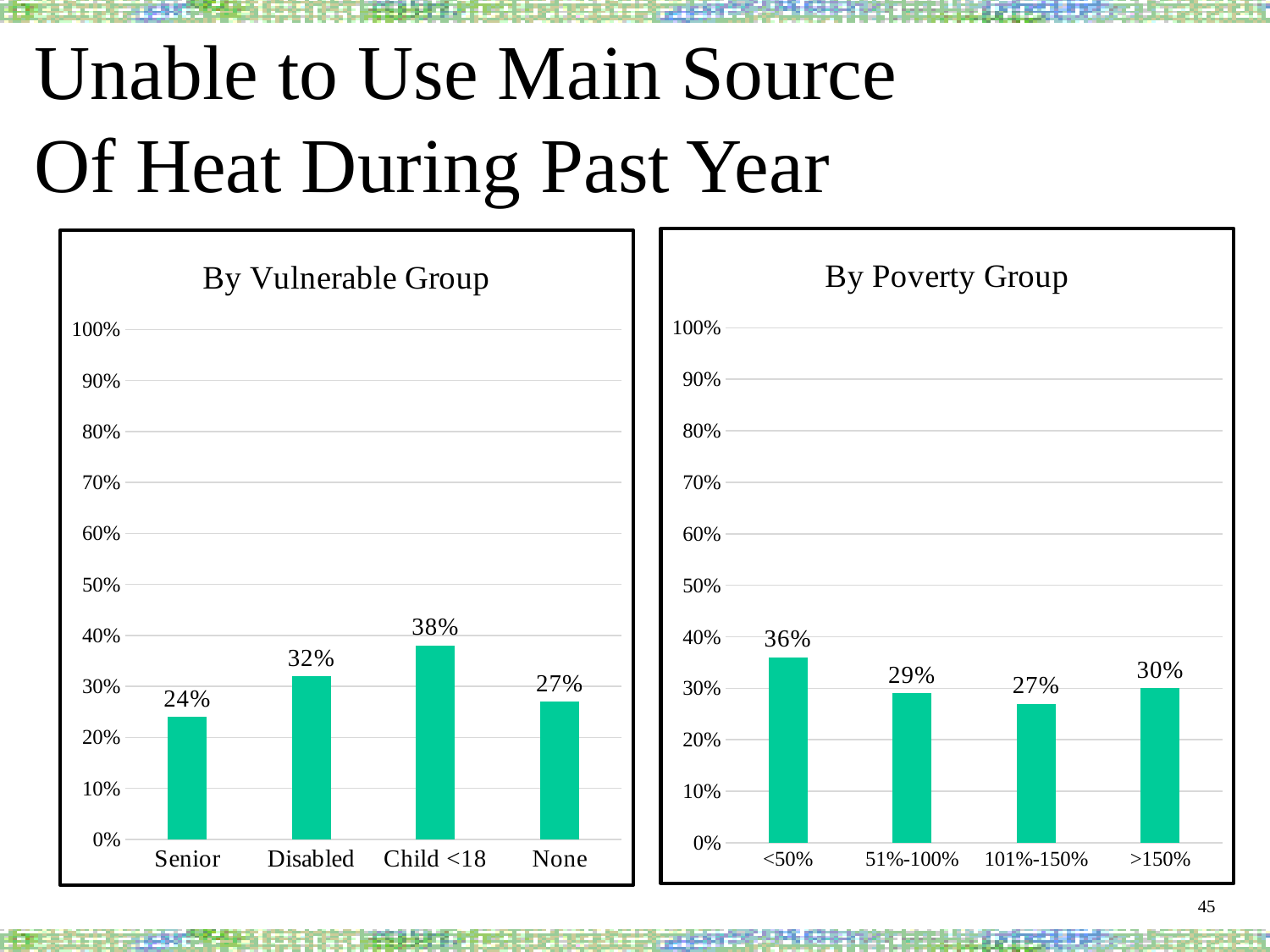
In the 'By Poverty Group' chart, which category has the lowest value? 101%-150% What is the title of the chart on the right side of the slide? By Poverty Group In the 'By Vulnerable Group' chart, what is the difference between the values for Child <18 and Senior? 14% In the 'By Vulnerable Group' chart, which is larger, the value for Disabled or the value for None? Disabled In the 'By Vulnerable Group' chart, what is the value for Disabled? 32% In the 'By Vulnerable Group' chart, which category has the highest value? Child <18 In the 'By Poverty Group' chart, what is the value for 101%-150%? 27% How many categories are shown in the 'By Poverty Group' chart? 4 In the 'By Vulnerable Group' chart, which category has the lowest value? Senior In the 'By Poverty Group' chart, which category has the highest value? <50% In the 'By Poverty Group' chart, what is the difference between the values for <50% and >150%? 6% What kind of chart is the 'By Vulnerable Group' chart? Bar chart